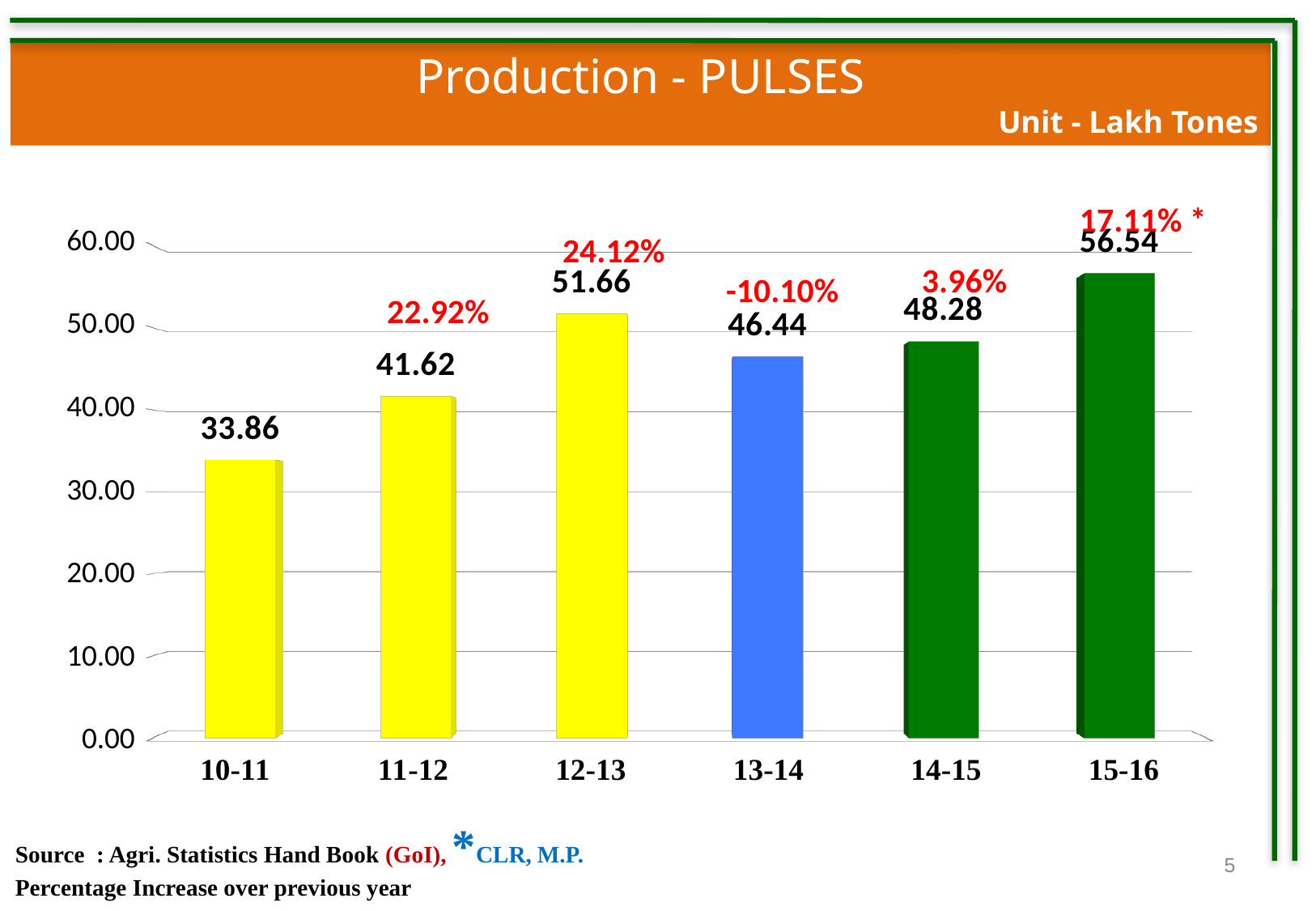
What is the difference in production between 15-16 and 14-15? 8.26 What is the pulses production value for 12-13? 51.66 Between 12-13 and 13-14, does production rise or fall? fall Is the production value for 11-12 greater or less than 40.00? greater What percentage change over the previous year is shown for 13-14? -10.10% What is the pulses production value for 10-11? 33.86 What kind of chart is shown on the slide? bar chart Which year has the highest pulses production? 15-16 Which is larger, the production in 12-13 or in 13-14? 12-13 How many years are shown on the x axis? 6 Which year has the lowest pulses production? 10-11 What unit is stated for the production values? Lakh Tones